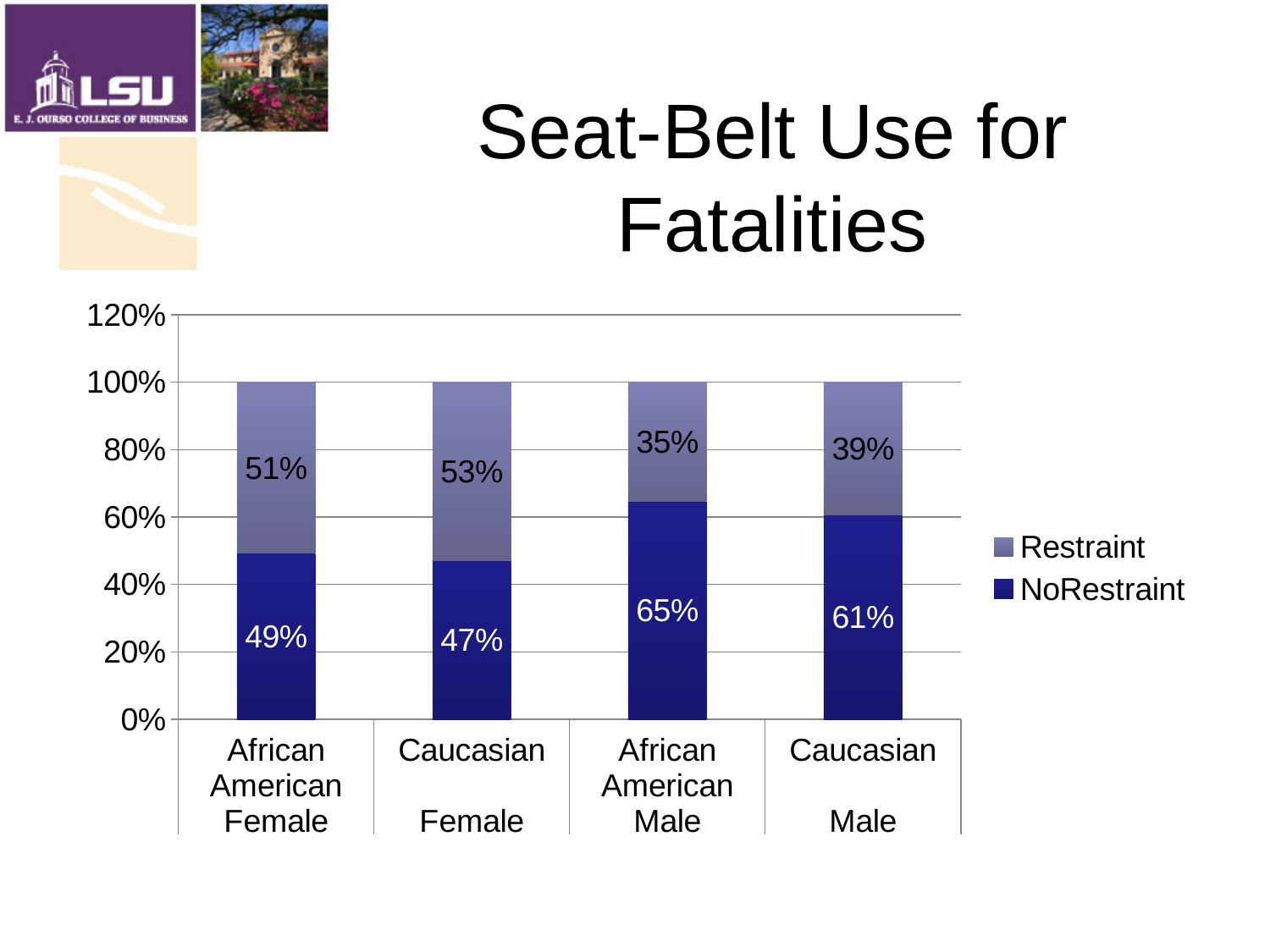
What is the NoRestraint value for Caucasian Male? 61% How many series does the legend list? 2 What is the title of the chart on the slide? Seat-Belt Use for Fatalities What is the NoRestraint value for African American Male? 65% Which is larger, the Restraint value for Caucasian Male or the Restraint value for Caucasian Female? Caucasian Female How many categories are shown on the x axis? 4 What kind of chart is shown on the slide? Stacked bar chart Which category has the highest NoRestraint value? African American Male What is the Restraint value for African American Female? 51% What is the Restraint value for Caucasian Female? 53% What is the difference between the NoRestraint values for African American Male and Caucasian Female? 18% Which category has the lowest Restraint value? African American Male